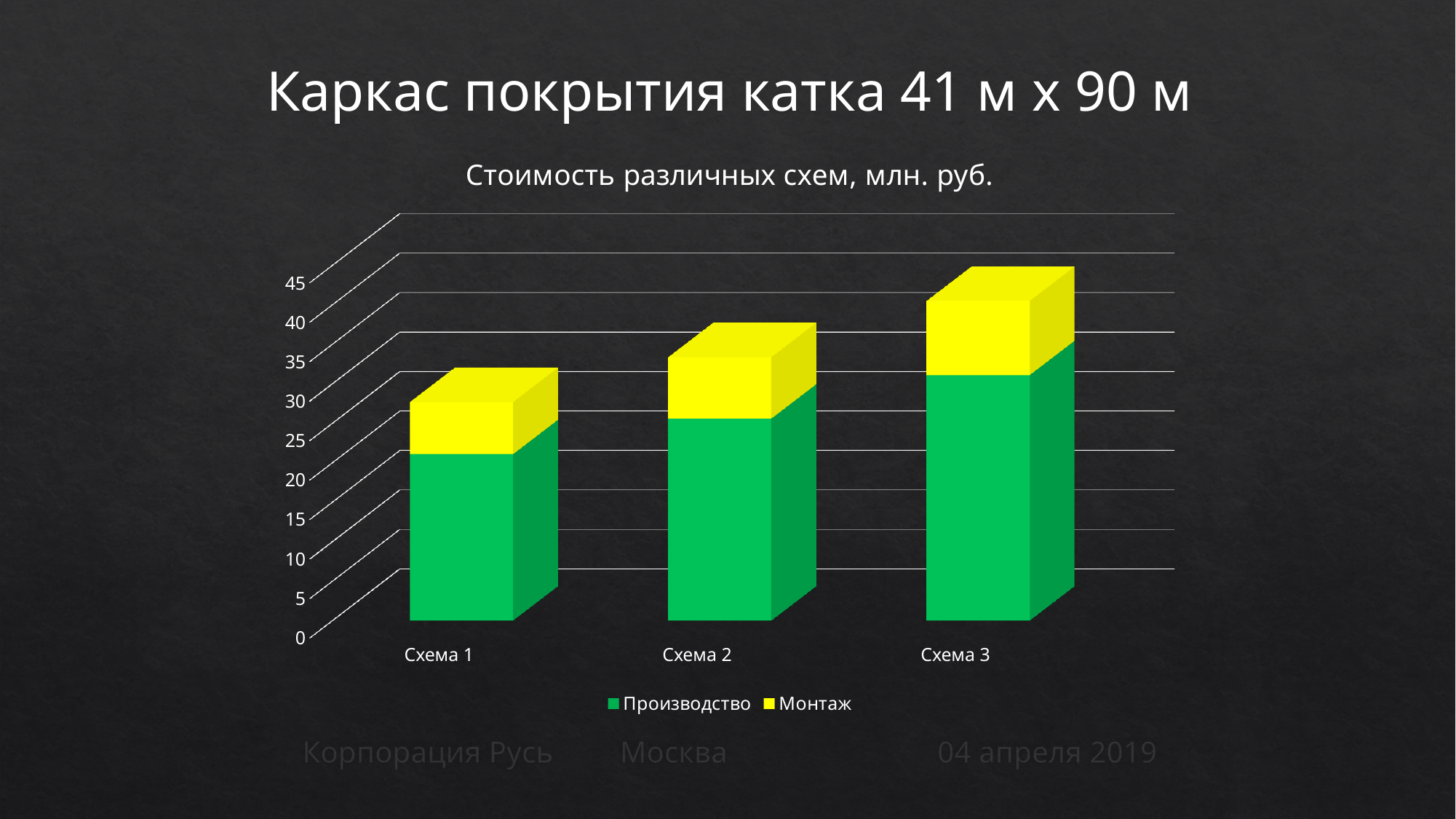
Which scheme has the highest total cost? Схема 3 How many categories (schemes) are shown on the x axis? 3 Which has the larger total cost, Схема 1 or Схема 3? Схема 3 How many series does the legend list? 2 Do the total costs rise or fall from Схема 1 to Схема 3? rise Is the total value for Схема 3 greater or less than 35? greater Which has the larger Производство value, Схема 2 or Схема 3? Схема 3 What kind of chart is shown on the slide? Stacked bar chart Is the Производство value for Схема 1 greater or less than 25? less Which scheme has the lowest total cost? Схема 1 What is the title of the chart? Стоимость различных схем, млн. руб. Which series are listed in the legend? Производство, Монтаж